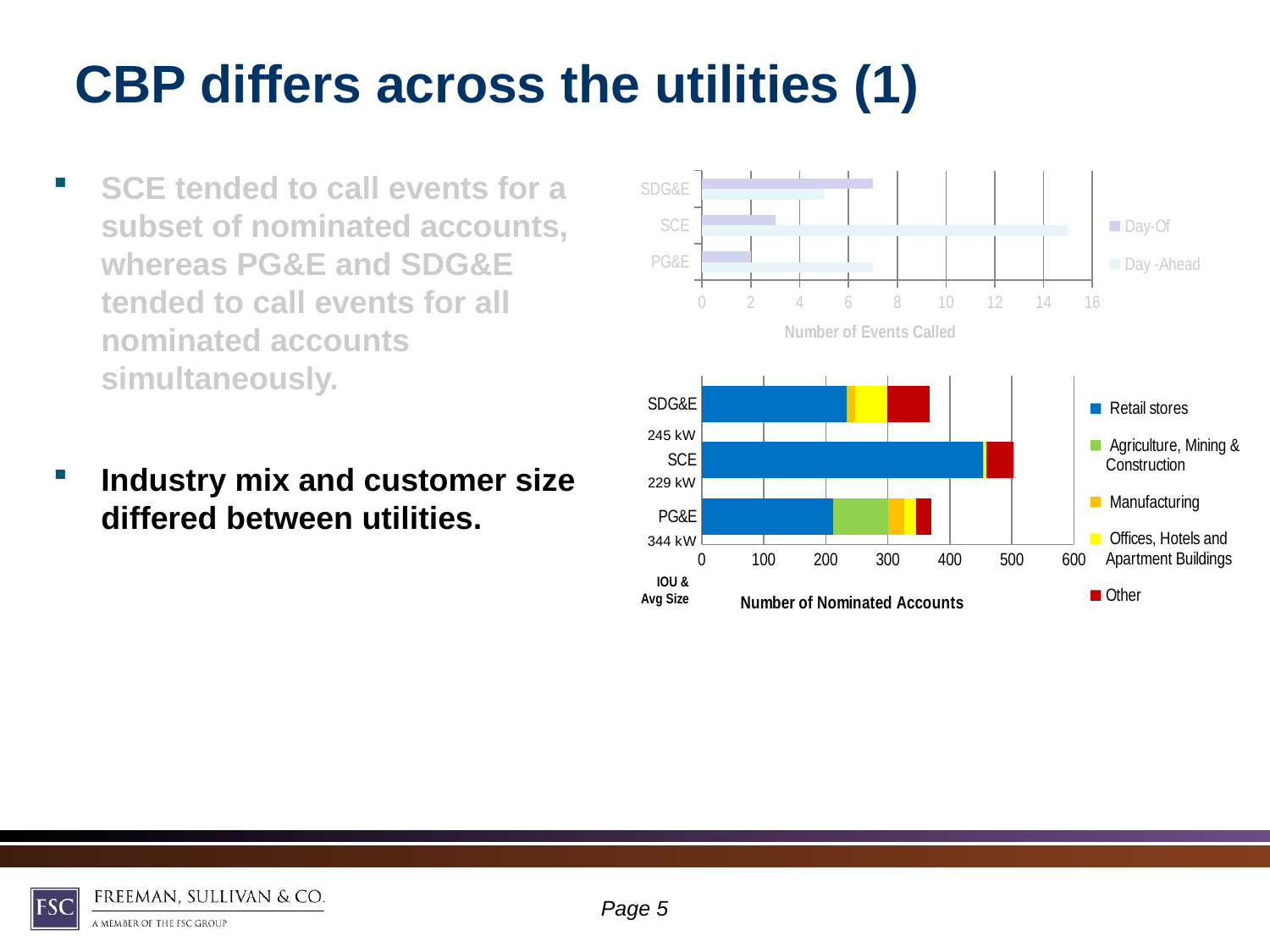
On the 'Number of Events Called' chart, how many utilities are shown on the vertical axis? 3 On the 'Number of Nominated Accounts' chart, is the total for SCE greater or less than 400? greater On the 'Number of Events Called' chart, is the Day-Ahead value for SCE greater or less than 14? greater On the 'Number of Events Called' chart, what kind of chart is shown? bar chart On the 'Number of Nominated Accounts' chart, how many series does the legend list? 5 On the 'Number of Events Called' chart, how many series does the legend list? 2 On the 'Number of Nominated Accounts' chart, which series is shown in green in the legend? Agriculture, Mining & Construction On the 'Number of Events Called' chart, which utility has the highest Day-Ahead value? SCE On the 'Number of Events Called' chart, for SDG&E, which is larger: Day-Of or Day-Ahead? Day-Of On the 'Number of Nominated Accounts' chart, which utility has the largest total number of nominated accounts? SCE On the 'Number of Events Called' chart, is the Day-Of value for PG&E greater or less than 4? less On the 'Number of Events Called' chart, which utility has the lowest Day-Of value? PG&E